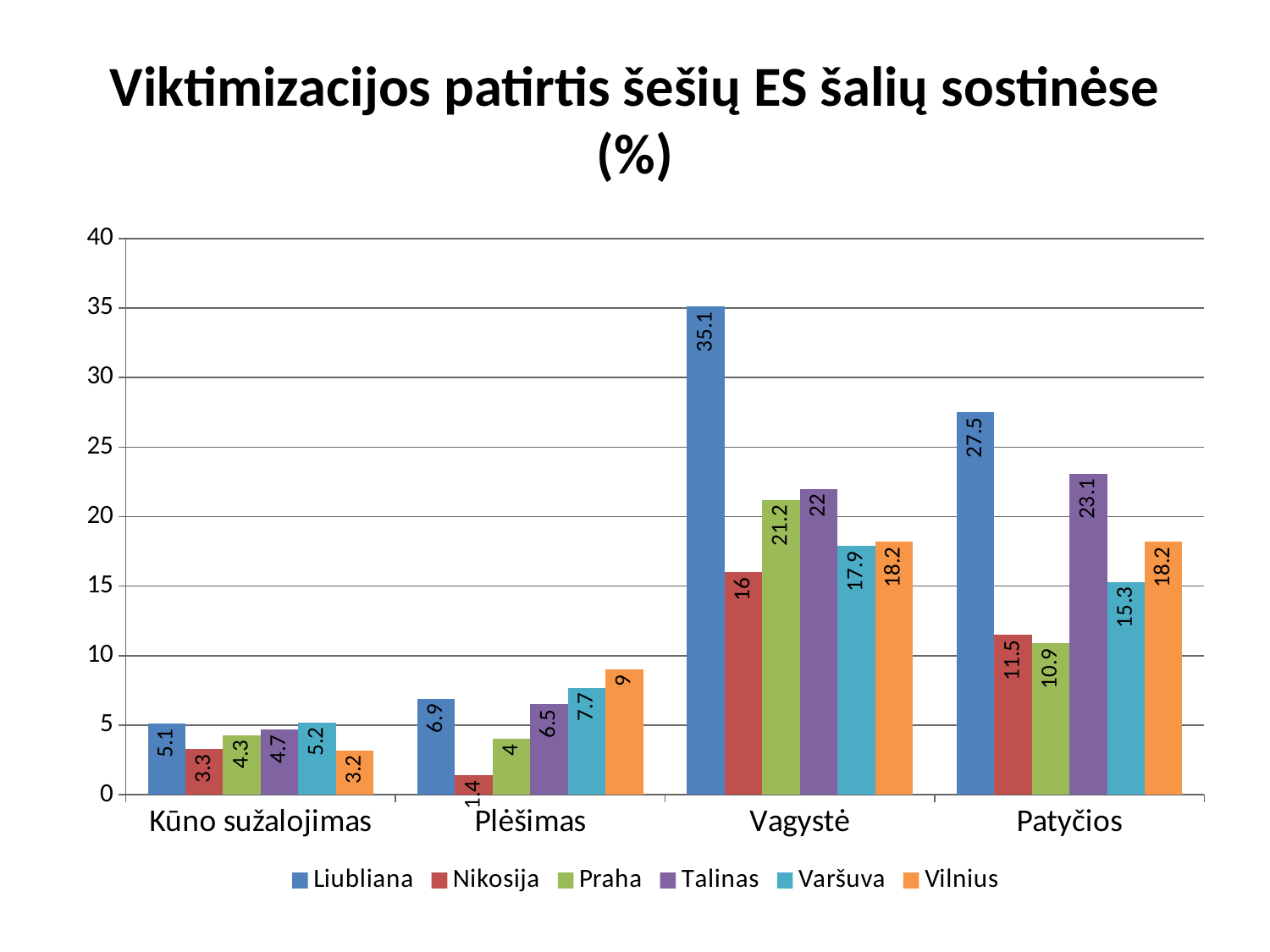
What is the value for Vilnius in the Plėšimas category? 9 What kind of chart is shown on the slide? bar chart Is the value for Talinas in the Vagystė category greater or less than 20? greater Which city has the highest value in the Patyčios category? Liubliana What is the value for Liubliana in the Vagystė category? 35.1 Which city has the lowest value in the Kūno sužalojimas category? Vilnius How many series does the legend list? 6 Which is larger in the Patyčios category: Praha or Varšuva? Varšuva What is the value for Varšuva in the Kūno sužalojimas category? 5.2 How many categories are shown on the x axis? 4 What is the value for Talinas in the Patyčios category? 23.1 What is the difference between Liubliana and Nikosija in the Vagystė category? 19.1